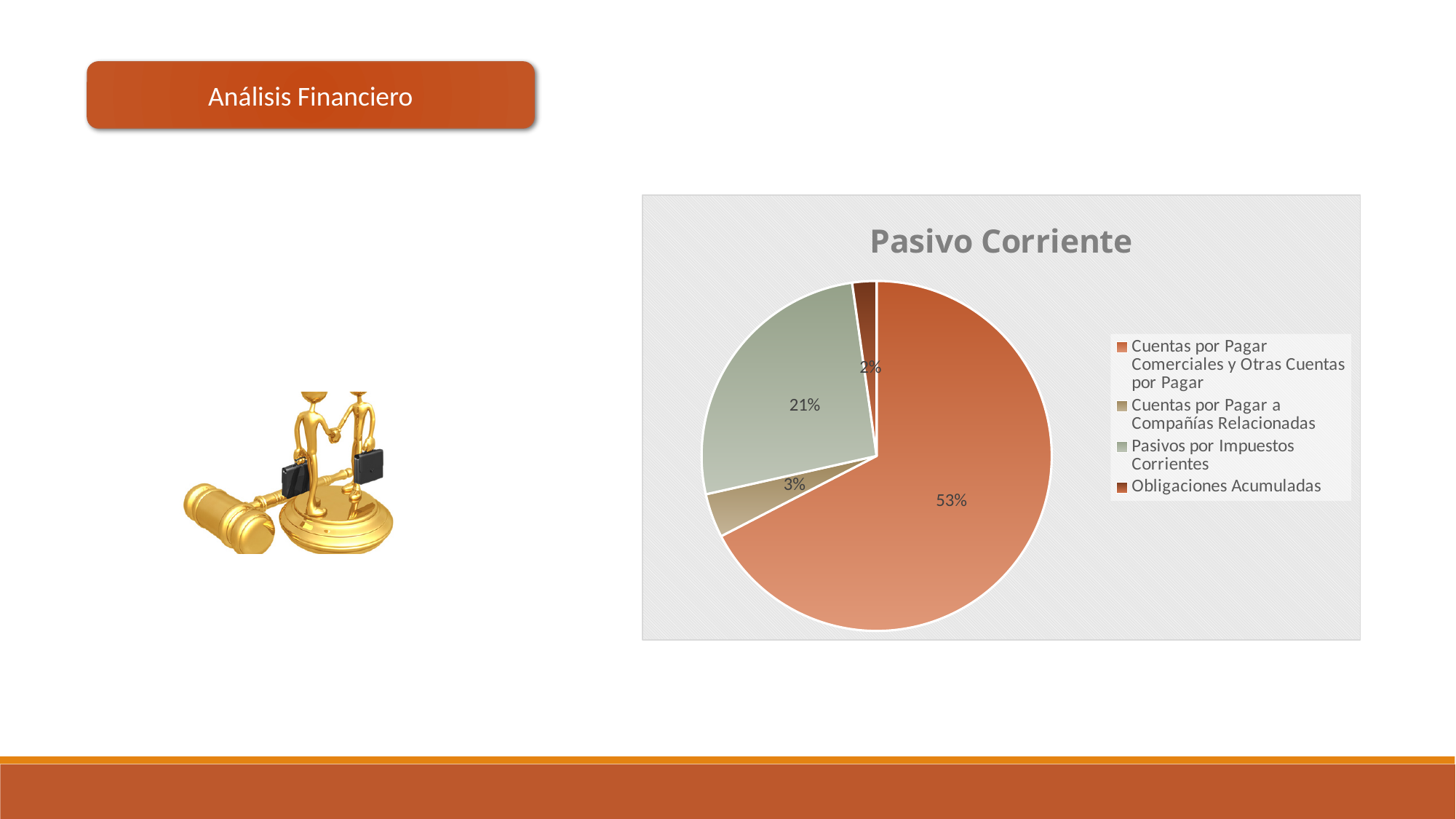
What percentage is shown for Cuentas por Pagar Comerciales y Otras Cuentas por Pagar? 53% Which is larger, Pasivos por Impuestos Corrientes or Cuentas por Pagar a Compañías Relacionadas? Pasivos por Impuestos Corrientes What percentage is shown for Obligaciones Acumuladas? 2% What percentage is shown for Pasivos por Impuestos Corrientes? 21% How many categories does the legend list? 4 What type of chart is shown on the slide? pie chart Which category has the largest slice of the pie? Cuentas por Pagar Comerciales y Otras Cuentas por Pagar Which category has the smallest slice of the pie? Obligaciones Acumuladas What is the difference in percentage points between Cuentas por Pagar Comerciales y Otras Cuentas por Pagar and Pasivos por Impuestos Corrientes? 32 What colour is the slice for Obligaciones Acumuladas? dark red What is the title of the chart? Pasivo Corriente What percentage is shown for Cuentas por Pagar a Compañías Relacionadas? 3%